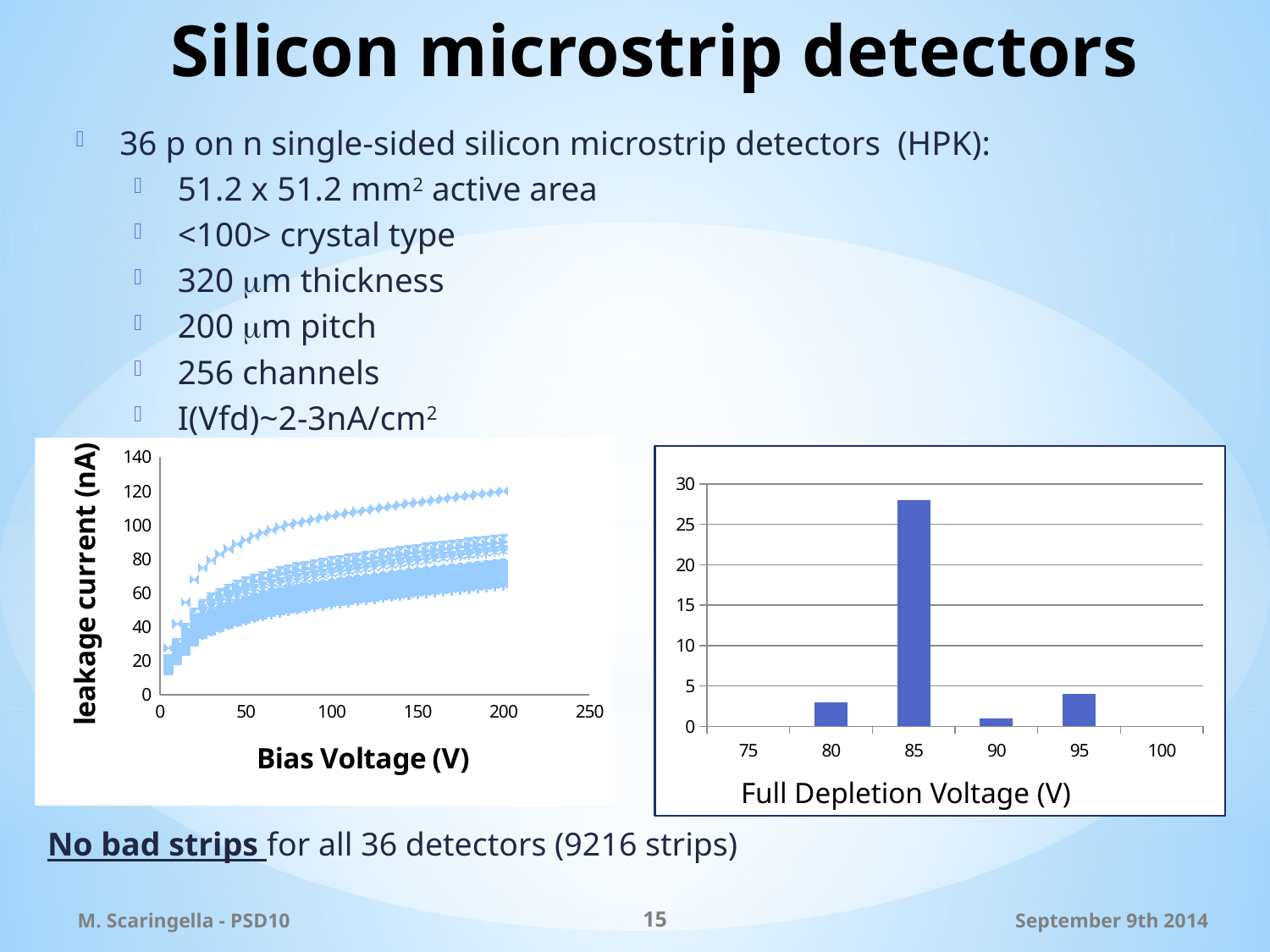
What is the y-axis title of the chart on the left? leakage current (nA) In the leakage current chart on the left, do the values rise or fall as Bias Voltage increases? rise What is the x-axis title of the chart on the right? Full Depletion Voltage (V) In the Full Depletion Voltage chart on the right, is the value for 95 greater or less than 10? less In the Full Depletion Voltage chart on the right, which category has the highest bar? 85 What kind of chart is the chart on the right (Full Depletion Voltage)? bar chart In the Full Depletion Voltage chart on the right, is the value for 80 greater or less than 5? less In the Full Depletion Voltage chart on the right, which is larger, the value for 85 or the value for 95? 85 In the Full Depletion Voltage chart on the right, how many categories are shown on the x axis? 6 In the Full Depletion Voltage chart on the right, which of the categories 80, 85, 90 and 95 has the lowest bar? 90 In the leakage current chart on the left, is the highest series value at a bias voltage of 200 greater or less than 100? greater